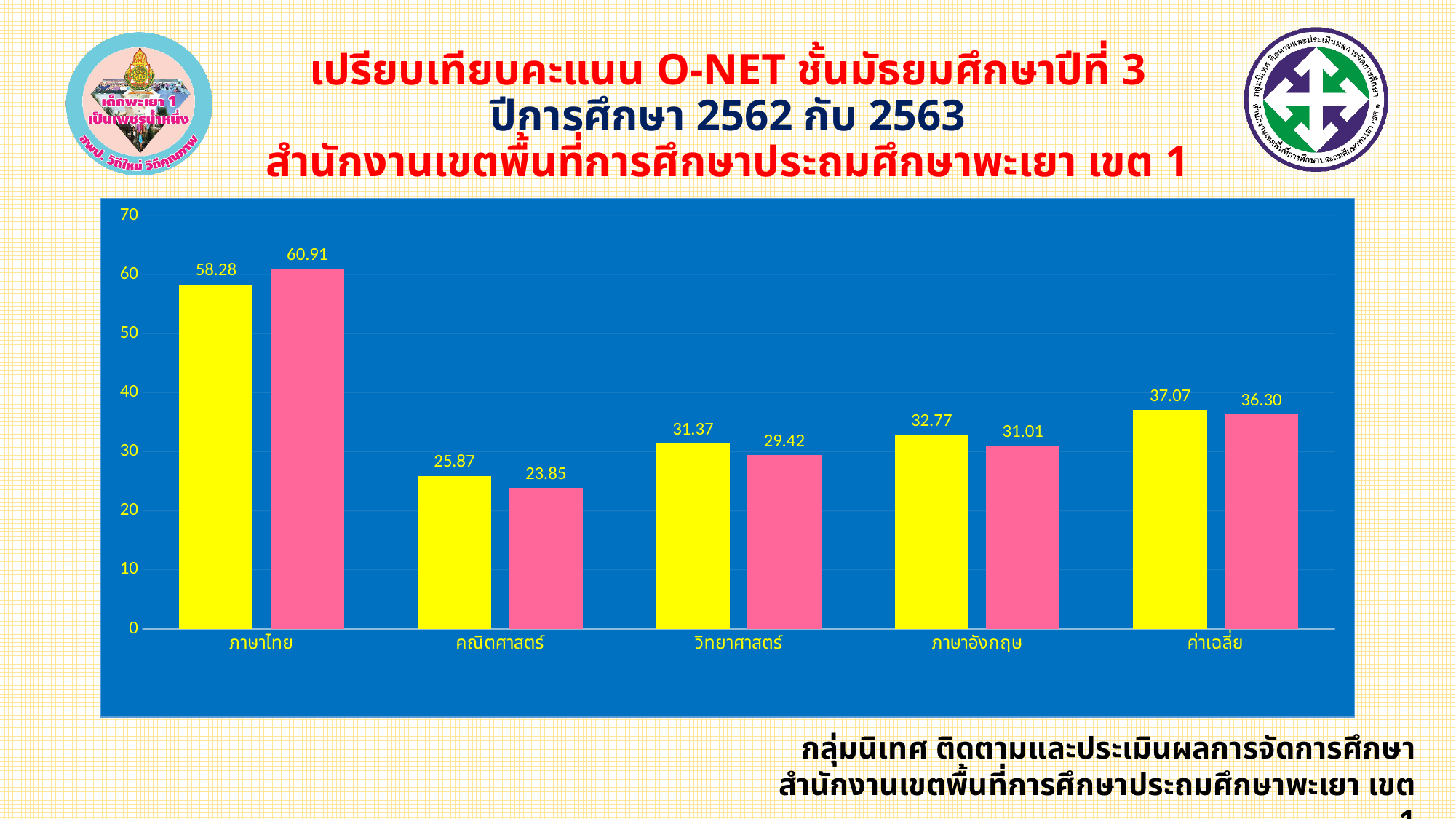
For คณิตศาสตร์, which is larger, the yellow bar or the pink bar? the yellow bar What is the difference between the pink and yellow bars for ภาษาไทย? 2.63 What is the difference between the yellow and pink bars for วิทยาศาสตร์? 1.95 What is the value of the pink bar for ค่าเฉลี่ย? 36.30 What is the value of the yellow bar for ภาษาไทย? 58.28 What is the value of the yellow bar for ภาษาอังกฤษ? 32.77 Which category has the lowest yellow bar? คณิตศาสตร์ How many categories are shown on the x axis? 5 What is the value of the pink bar for คณิตศาสตร์? 23.85 What two colours are used for the bars in the chart? yellow and pink What kind of chart is shown on the slide? bar chart Which category has the highest pink bar? ภาษาไทย